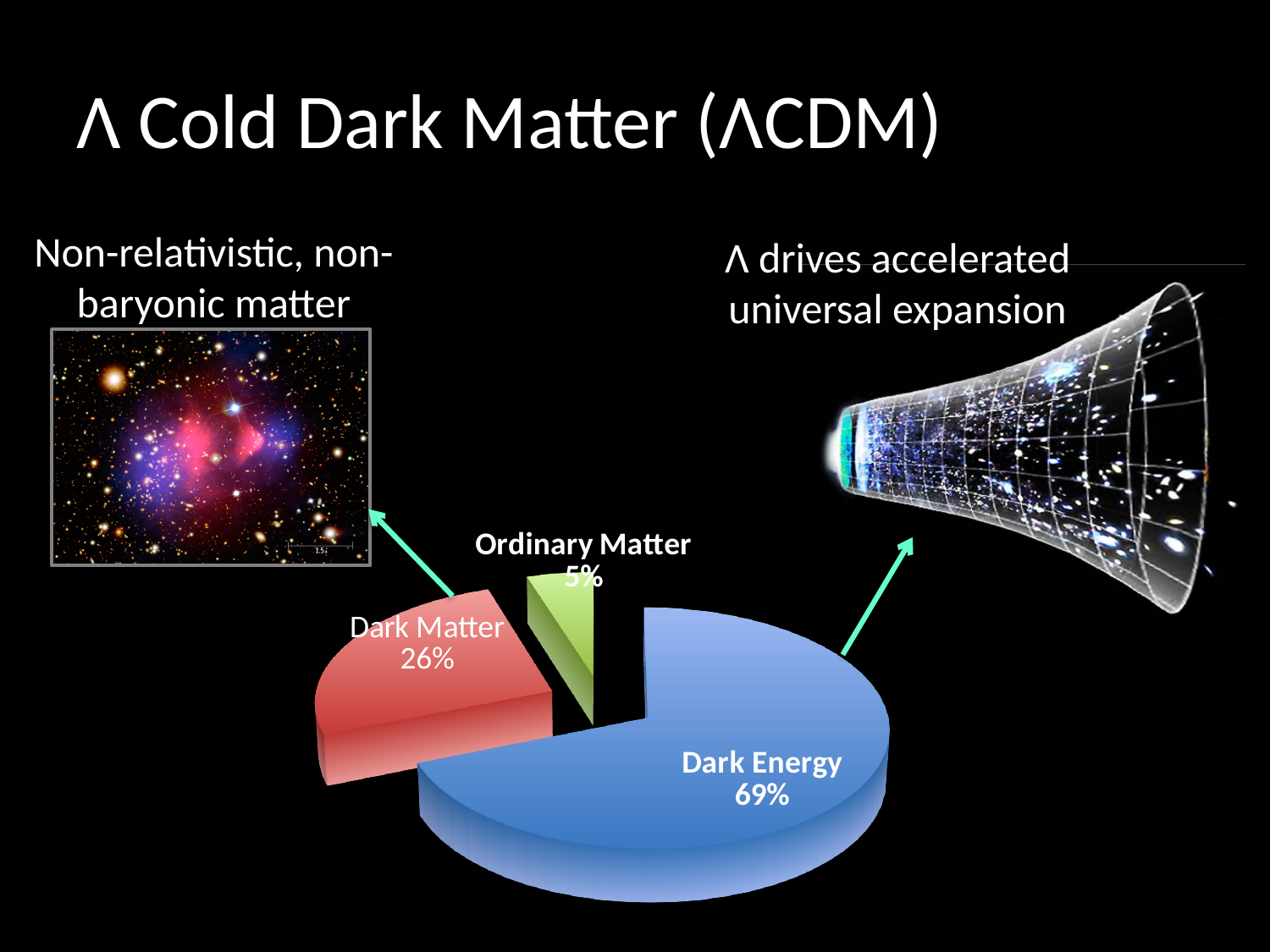
What is the difference in percentage points between Dark Matter and Ordinary Matter? 21 How many slices does the pie chart have? 3 What colour is the Dark Energy slice of the pie chart? blue What share of the pie does Dark Energy represent? 69% What kind of chart is shown on the slide? pie chart What share of the pie does Dark Matter represent? 26% What is the difference in percentage points between Dark Energy and Dark Matter? 43 What colour is the Ordinary Matter slice of the pie chart? green What share of the pie does Ordinary Matter represent? 5% Which slice of the pie chart is the smallest? Ordinary Matter Which slice of the pie chart is the largest? Dark Energy Which is larger, the Dark Matter slice or the Ordinary Matter slice? Dark Matter